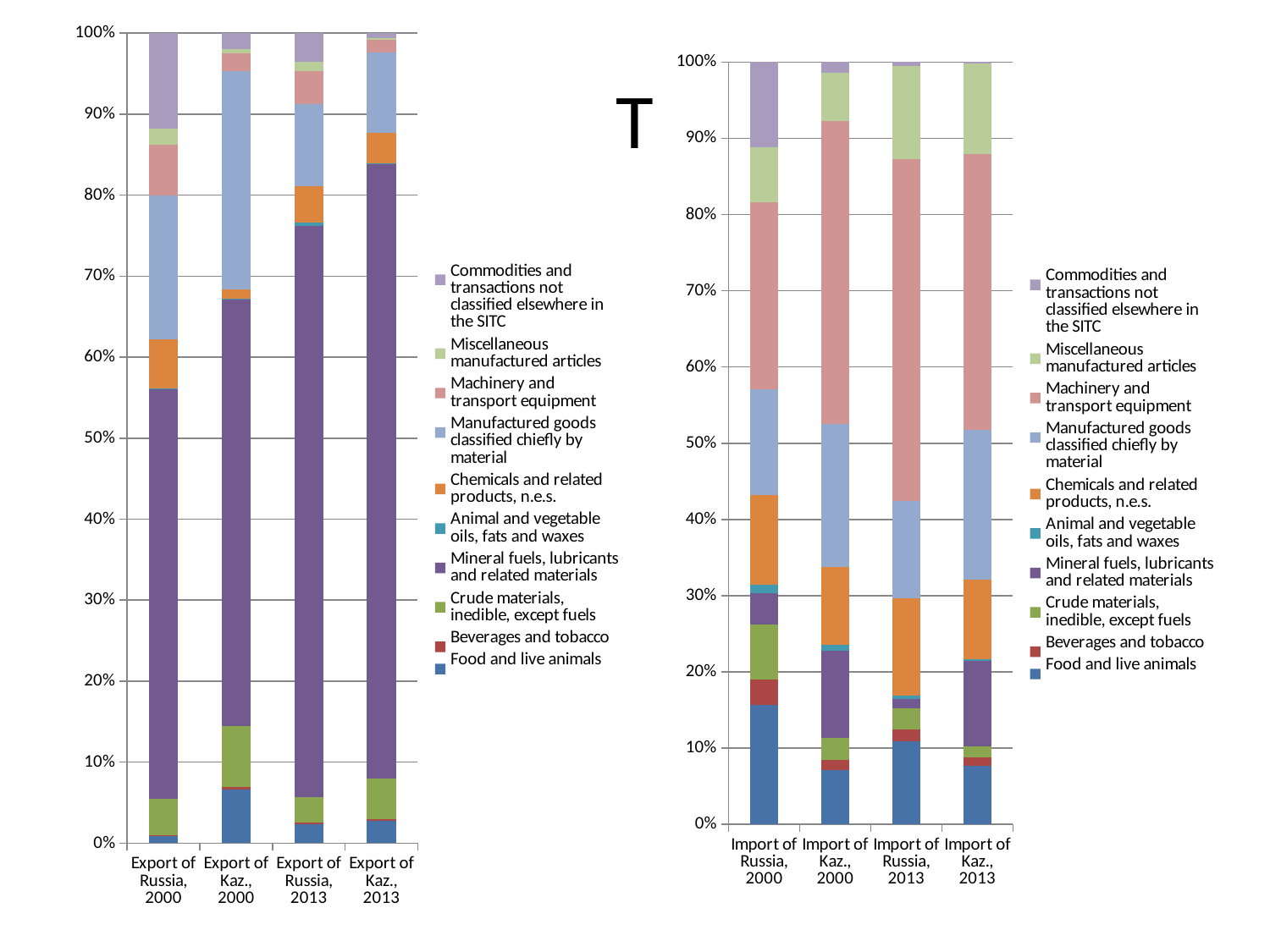
In the right chart showing imports, which is larger: the Food and live animals segment for Import of Russia, 2000 or for Import of Kaz., 2000? Import of Russia, 2000 In the left chart showing exports, which bar has the largest segment for Commodities and transactions not classified elsewhere in the SITC? Export of Russia, 2000 In the left chart showing exports, which is larger: the Mineral fuels, lubricants and related materials segment for Export of Kaz., 2013 or for Export of Russia, 2000? Export of Kaz., 2013 What kind of chart is the left chart showing exports? Stacked bar chart In the right chart showing imports, which bar has the largest Food and live animals segment? Import of Russia, 2000 In the right chart showing imports, is the value for Machinery and transport equipment in Import of Kaz., 2000 greater or less than 30%? greater In the left chart showing exports, which series is listed last (at the bottom) in the legend? Food and live animals In the left chart showing exports, is the value for Mineral fuels, lubricants and related materials in Export of Kaz., 2013 greater or less than 70%? greater In the right chart showing imports, is the value for Food and live animals in Import of Russia, 2000 greater or less than 10%? greater How many series does the legend of the left chart showing exports list? 10 How many categories (bars) does the right chart showing imports have? 4